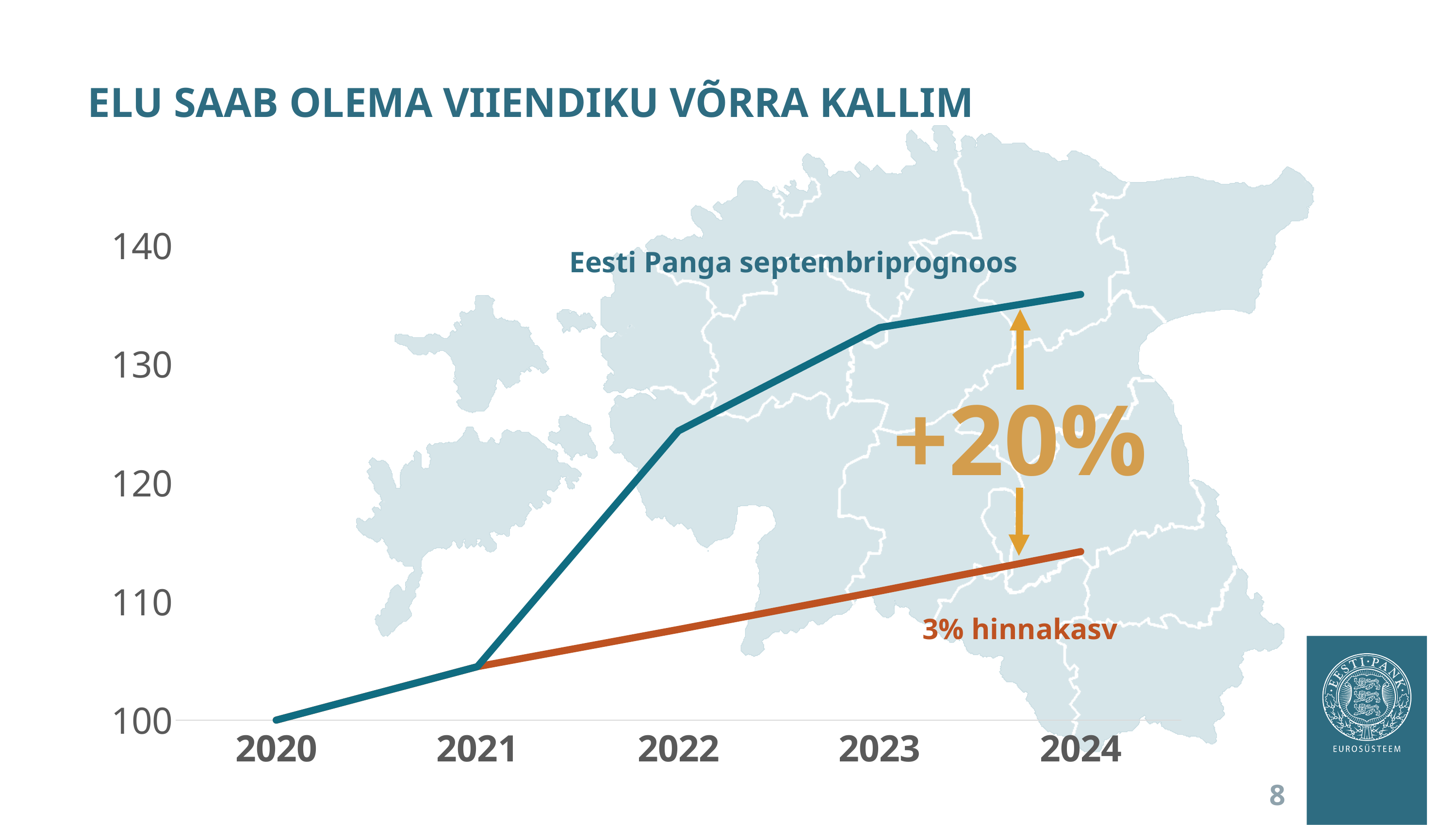
How many years are shown on the x axis of the chart? 5 What percentage is shown in the large annotation between the two lines? +20% What is the title of the slide? ELU SAAB OLEMA VIIENDIKU VÕRRA KALLIM In 2024, which line is higher: Eesti Panga septembriprognoos or 3% hinnakasv? Eesti Panga septembriprognoos Is the 2024 value for Eesti Panga septembriprognoos greater or less than 130? greater What kind of chart is shown on the slide? line chart Is the value of the line in 2021 greater or less than 110? less Does the Eesti Panga septembriprognoos line rise or fall from 2020 to 2024? rise Is the 2024 value for 3% hinnakasv greater or less than 120? less How many lines (series) are plotted on the chart? 2 What is the value of the line in 2020? 100